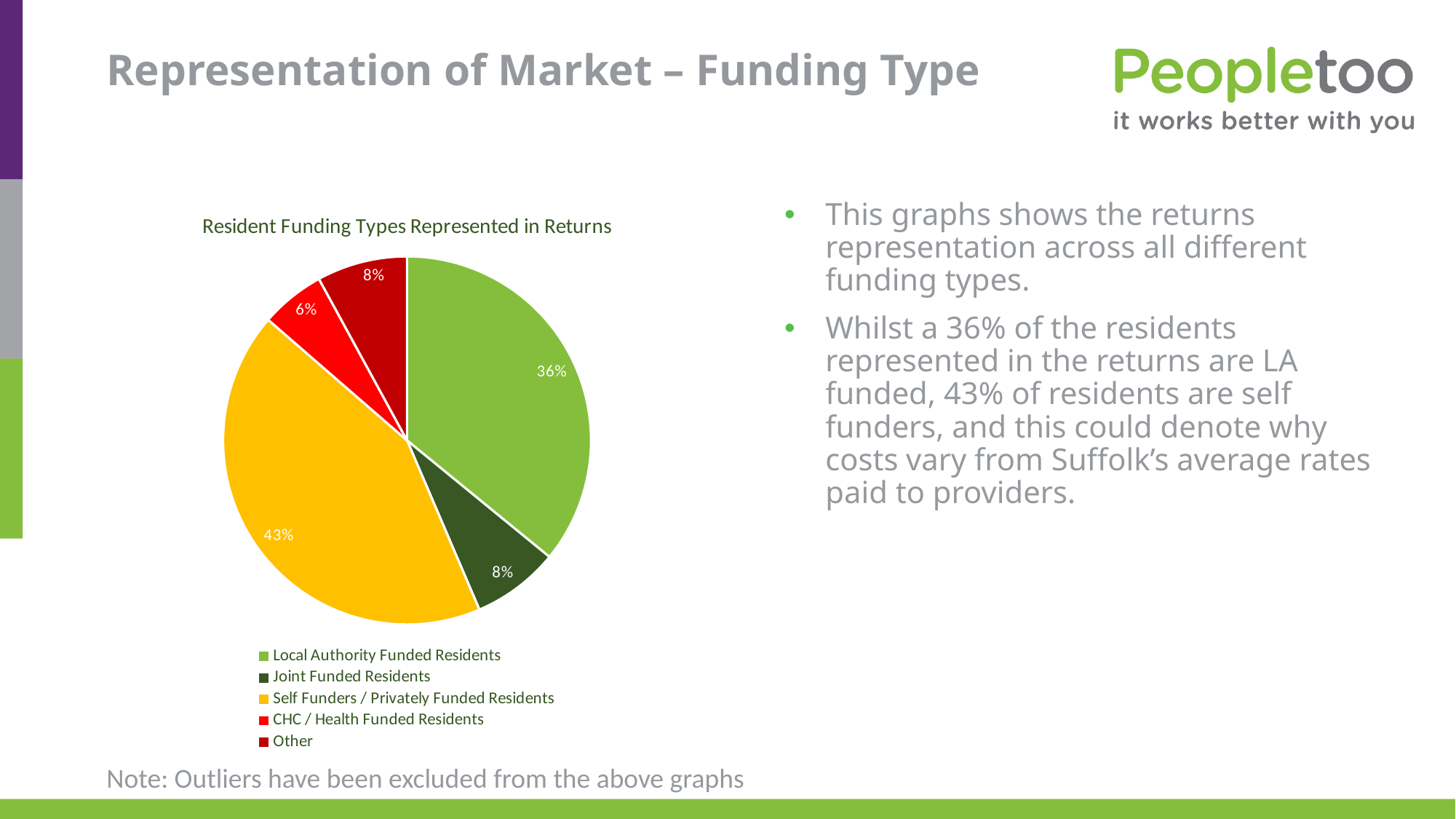
What share of the pie is Local Authority Funded Residents? 36% Which is larger, the share for Local Authority Funded Residents or the share for Joint Funded Residents? Local Authority Funded Residents What kind of chart is shown on the slide? Pie chart What is the difference in percentage points between Self Funders / Privately Funded Residents and Local Authority Funded Residents? 7 Which funding type has the largest slice of the pie? Self Funders / Privately Funded Residents What share of the pie is Other? 8% What share of the pie is CHC / Health Funded Residents? 6% Which funding type has the smallest slice of the pie? CHC / Health Funded Residents What is the title of the chart? Resident Funding Types Represented in Returns How many categories does the legend list? 5